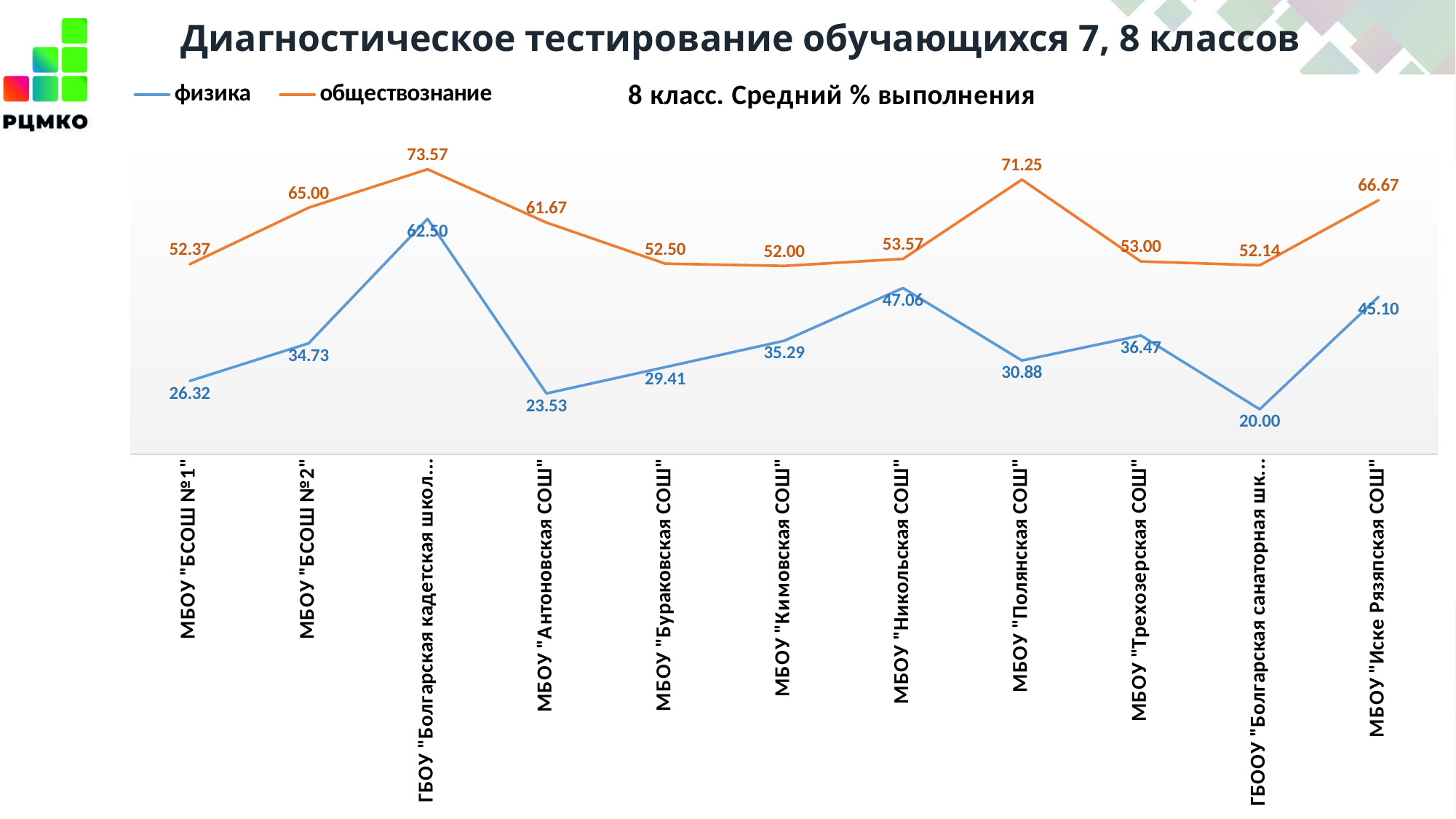
How many series does the legend list? 2 What is the title of the chart? 8 класс. Средний % выполнения What is the физика value for МБОУ "Иске Рязяпская СОШ"? 45.10 Which colour is used for the обществознание series? orange What type of chart is shown on the slide? line chart How many schools (categories) are plotted on the x axis? 11 What is the highest физика value shown on the chart? 62.50 Which school has the lowest обществознание value? МБОУ "Кимовская СОШ" What is the difference between the обществознание and физика values for МБОУ "Антоновская СОШ"? 38.14 What is the обществознание value for МБОУ "Полянская СОШ"? 71.25 What is the физика value for МБОУ "БСОШ №1"? 26.32 Which is larger for МБОУ "Никольская СОШ": the физика value or the обществознание value? обществознание